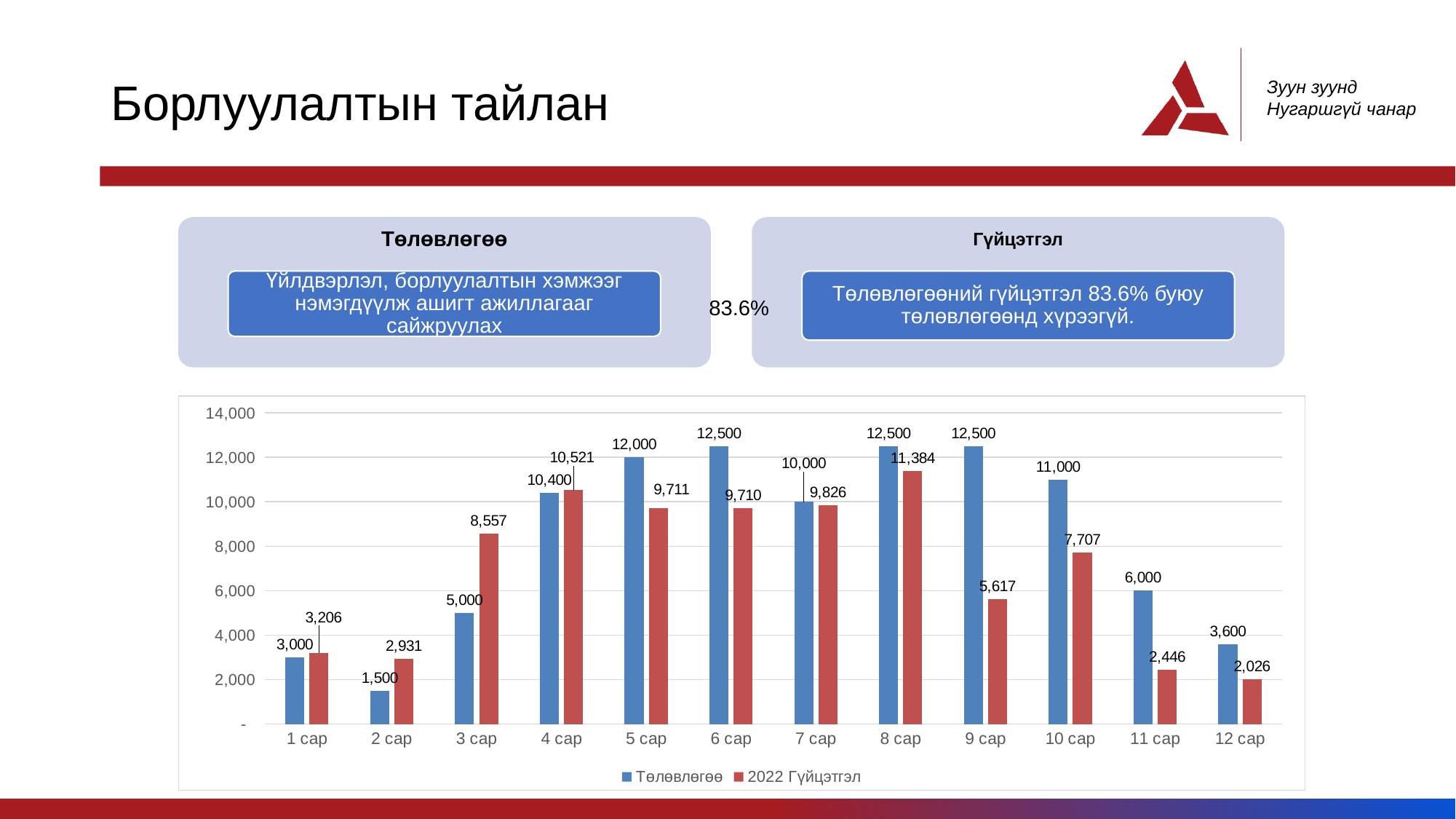
What is the value of Төлөвлөгөө for 5 сар? 12,000 What is the difference between Төлөвлөгөө and 2022 Гүйцэтгэл for 9 сар? 6,883 What is the value of 2022 Гүйцэтгэл for 9 сар? 5,617 For 1 сар, which is larger: Төлөвлөгөө or 2022 Гүйцэтгэл? 2022 Гүйцэтгэл Which month has the highest 2022 Гүйцэтгэл value? 8 сар What is the difference between 2022 Гүйцэтгэл and Төлөвлөгөө for 3 сар? 3,557 What kind of chart is shown on the slide? Bar chart How many series does the chart legend list? 2 Which month has the lowest Төлөвлөгөө value? 2 сар Which month has the lowest 2022 Гүйцэтгэл value? 12 сар How many months are shown on the x axis of the chart? 12 What is the value of 2022 Гүйцэтгэл for 4 сар? 10,521